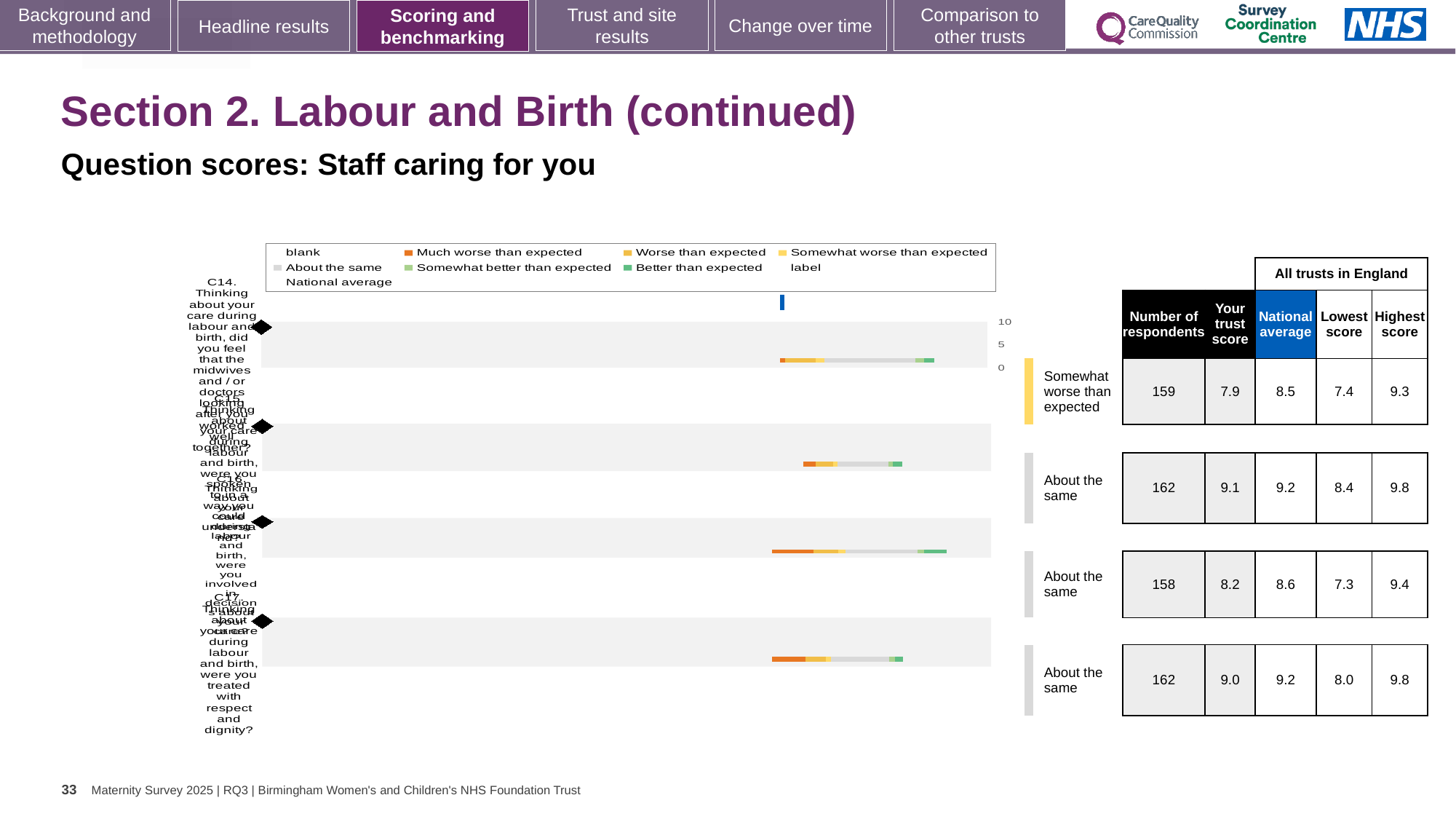
What kind of chart is shown on the slide? Bar chart In the table next to the chart, what is the number of respondents for the first (top) row? 159 In the table next to the chart, what is the 'Your trust score' for the first (top) row? 7.9 What benchmark label is shown for the first (top) row of the chart? Somewhat worse than expected Which row has the highest 'Your trust score' in the table next to the chart? The second row, 9.1 In the table next to the chart, what is the national average for the second row? 9.2 For the third row, which is larger: the trust score or the national average? National average (8.6) How many question rows (bars) does the chart show? 4 In the table next to the chart, what is the highest score for the third row? 9.4 In the table next to the chart, what is the lowest score for the fourth (bottom) row? 8.0 For the first (top) row, what is the difference between the national average and the trust score? 0.6 Which row has the lowest 'Your trust score' in the table next to the chart? The first (top) row, 7.9